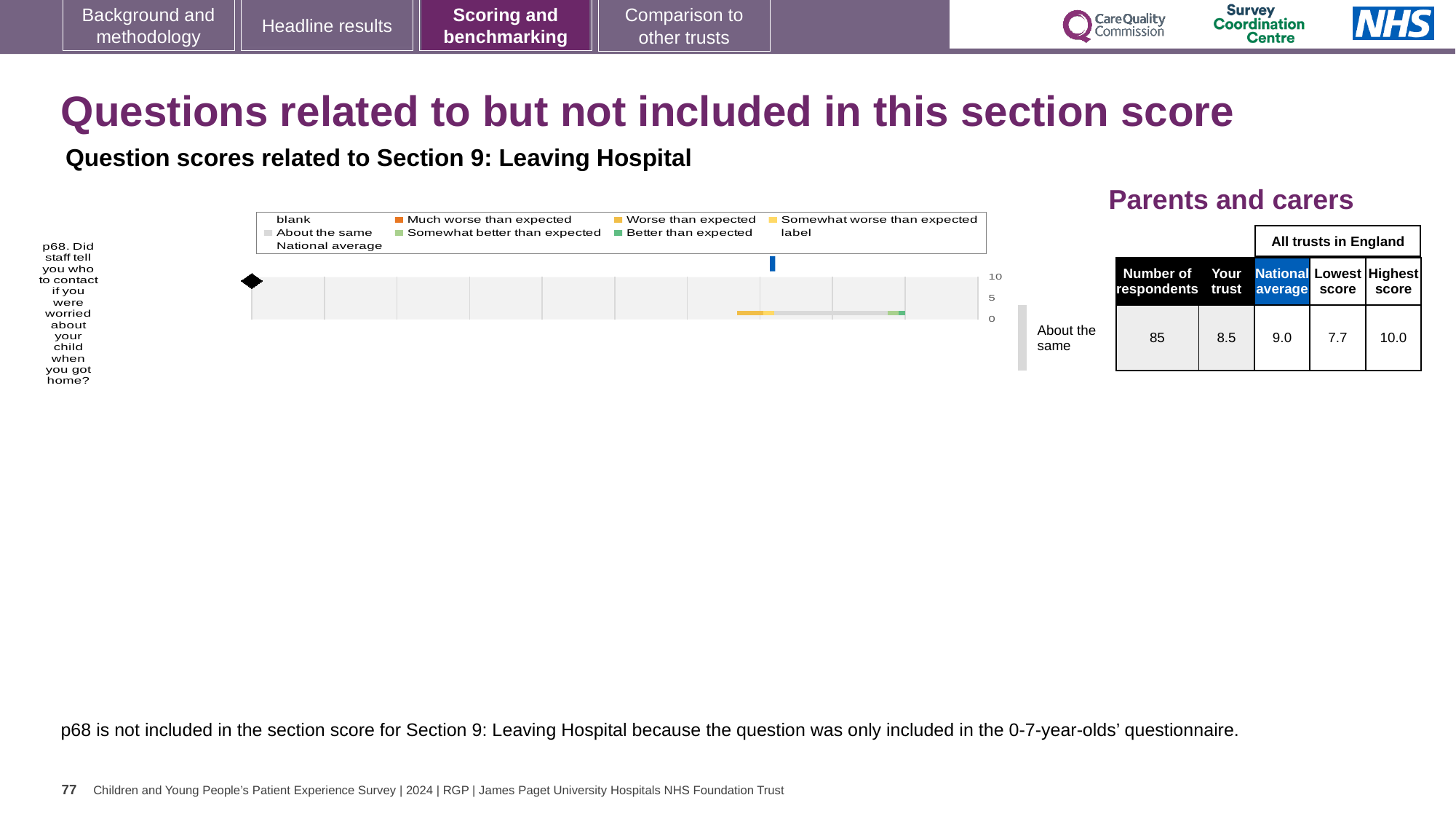
Is the national average for p68 greater or less than 5 on the chart axis? greater What is the difference between the highest score and the lowest score for p68? 2.3 How many survey questions are plotted on the chart? 1 How many respondents answered p68? 85 What is the highest score among all trusts in England for p68? 10.0 What is the lowest score among all trusts in England for p68? 7.7 Which is larger for p68: the 'Your trust' score or the national average? National average Which benchmark category is the trust's p68 result labelled as? About the same What is the 'Your trust' score for p68 shown on the slide? 8.5 What kind of chart is used to show the p68 question score? bar chart What is the national average score for p68? 9.0 What is the difference between the national average and the 'Your trust' score for p68? 0.5